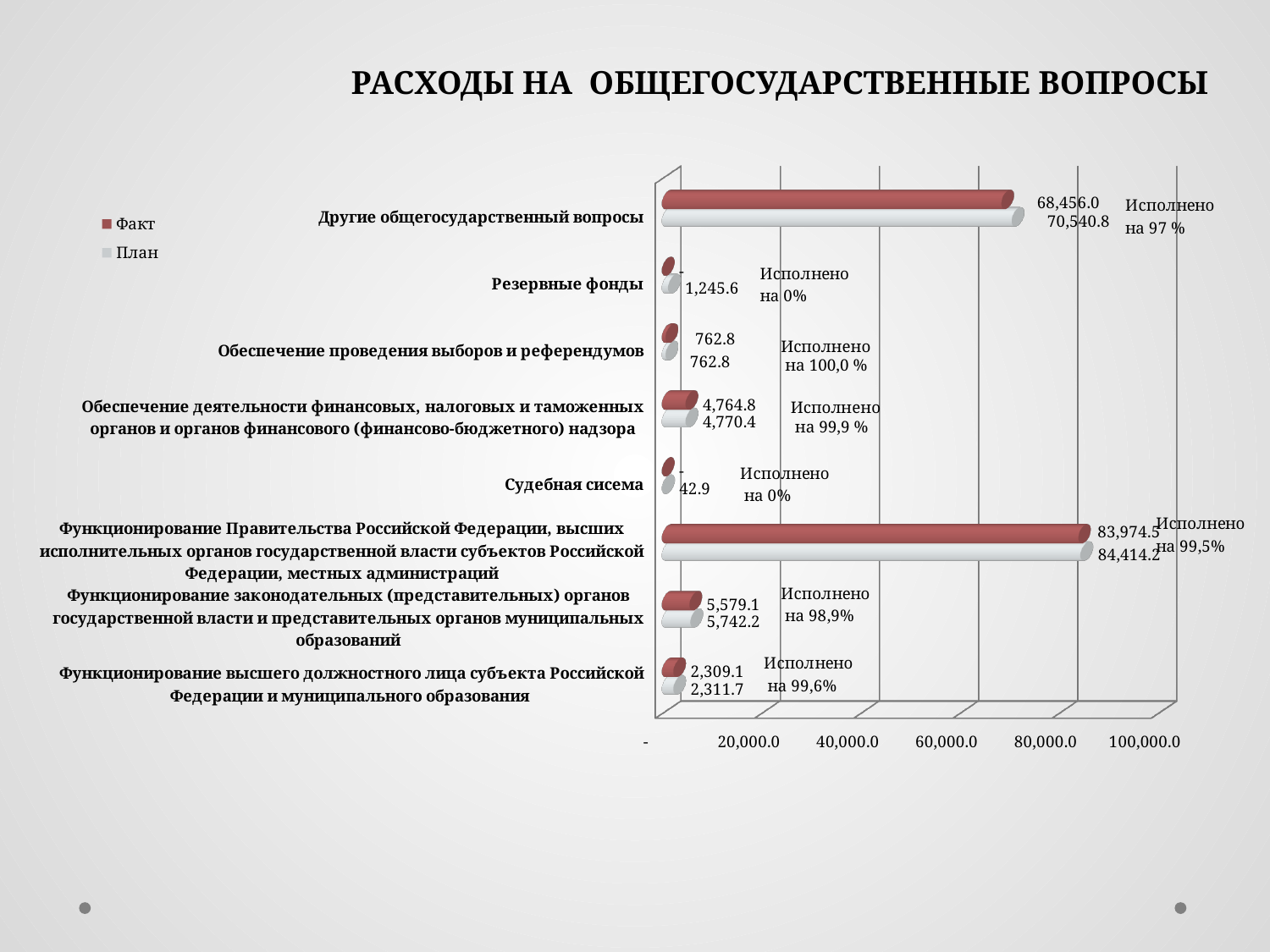
How many categories are shown on the chart? 8 What is the Факт value for Функционирование законодательных (представительных) органов государственной власти и представительных органов муниципальных образований? 5,579.1 What is the difference between the План and Факт values for Другие общегосударственный вопросы? 2,084.8 Which category has the lowest План value? Судебная сисема Which is larger for Функционирование высшего должностного лица субъекта Российской Федерации и муниципального образования: the Факт value or the План value? План What kind of chart is shown on the slide? Bar chart What is the Факт value for Другие общегосударственный вопросы? 68,456.0 Which category has the highest План value? Функционирование Правительства Российской Федерации, высших исполнительных органов государственной власти субъектов Российской Федерации, местных администраций What is the План value for Судебная сисема? 42.9 How many series does the legend list? 2 What is the План value for Другие общегосударственный вопросы? 70,540.8 What is the План value for Резервные фонды? 1,245.6